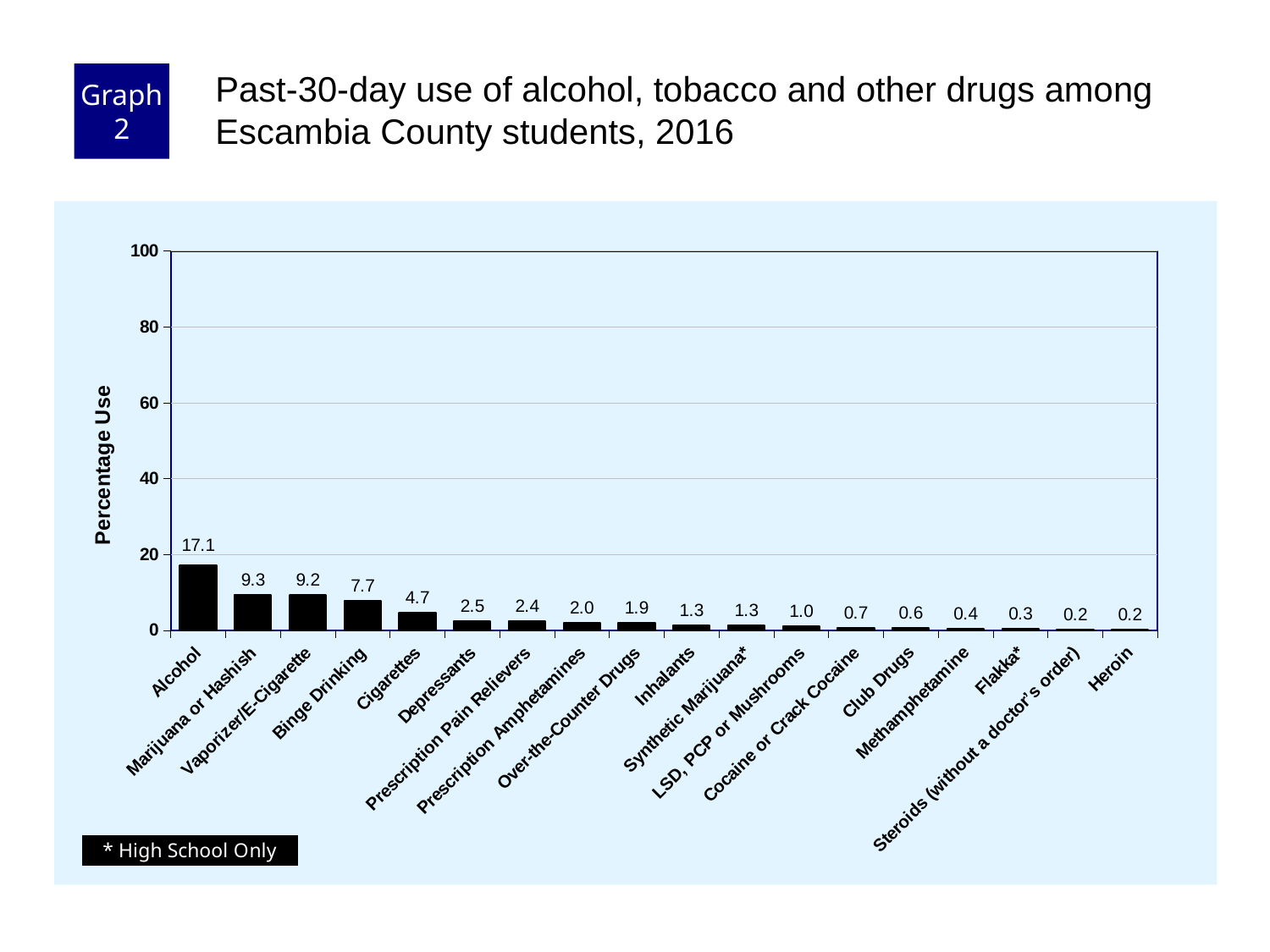
What is the difference between the values for Cigarettes and Depressants? 2.2 What value is shown for Inhalants? 1.3 What is the difference between the values for Alcohol and Marijuana or Hashish? 7.8 Which is larger, the value for Binge Drinking or the value for Cigarettes? Binge Drinking How many categories are shown on the x axis? 18 Is the value for Alcohol greater or less than 20? less What value is shown for Methamphetamine? 0.4 What kind of chart is shown on the slide? bar chart What is the past-30-day use percentage for Alcohol? 17.1 Which category has the highest percentage use? Alcohol Do the values rise or fall moving from left to right along the x axis? fall What value is shown for Vaporizer/E-Cigarette? 9.2